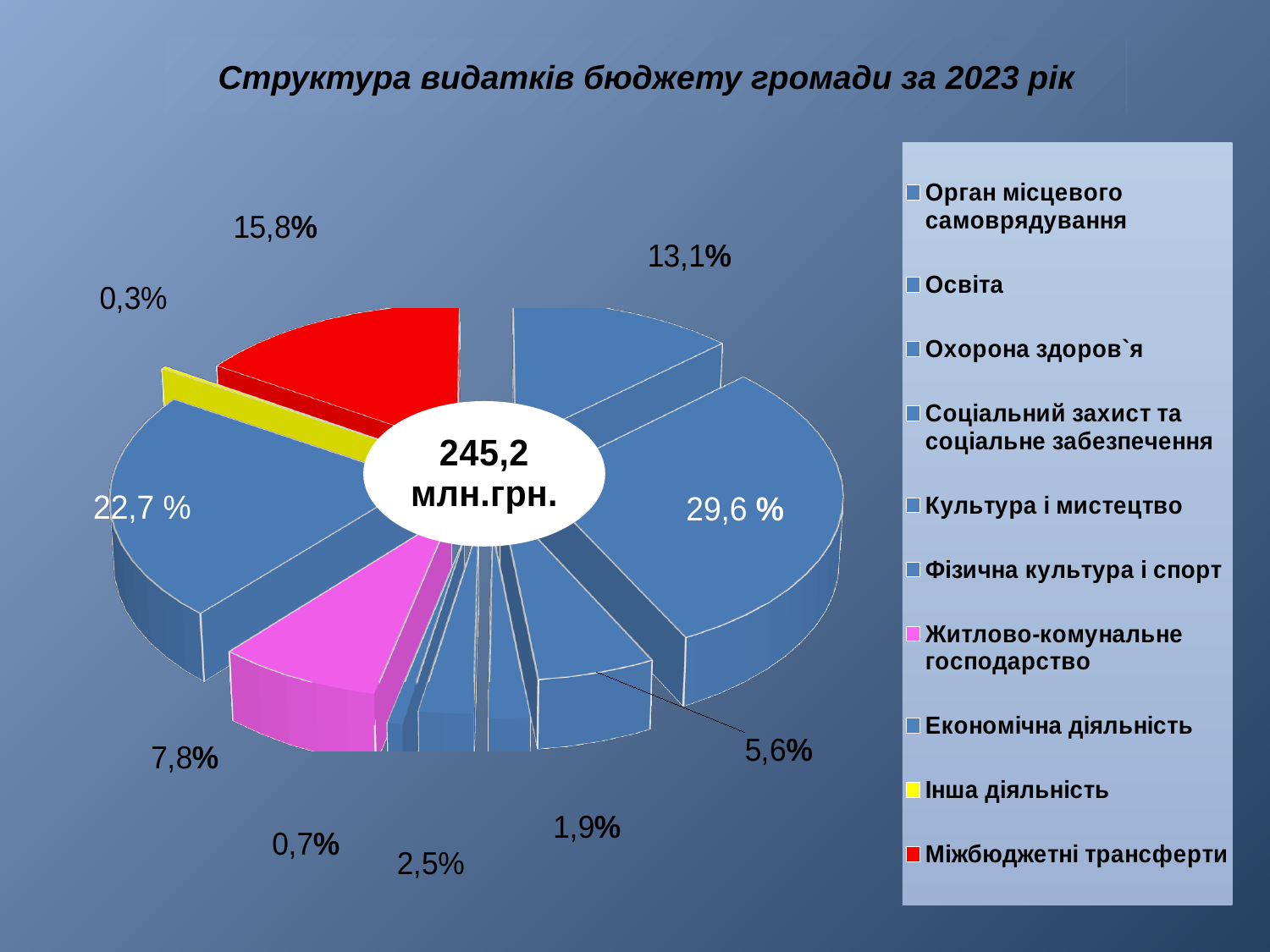
What total amount is shown in the centre of the pie chart? 245,2 млн.грн. What share is shown for Інша діяльність (the yellow slice)? 0,3% What share of the budget expenditures is shown for Житлово-комунальне господарство (the pink slice)? 7,8% By how many percentage points does the share of Міжбюджетні трансферти exceed that of Житлово-комунальне господарство? 8,0% Which category has the smallest share on the pie chart? Інша діяльність How many percentage labels are shown around the pie chart? 10 What type of chart is shown on the slide? pie chart How many categories does the legend of the pie chart list? 10 What is the title of the chart on the slide? Структура видатків бюджету громади за 2023 рік Which has the larger share: Міжбюджетні трансферти or Житлово-комунальне господарство? Міжбюджетні трансферти What is the largest percentage value labelled on the pie chart? 29,6 % What share is shown for Міжбюджетні трансферти (the red slice)? 15,8%